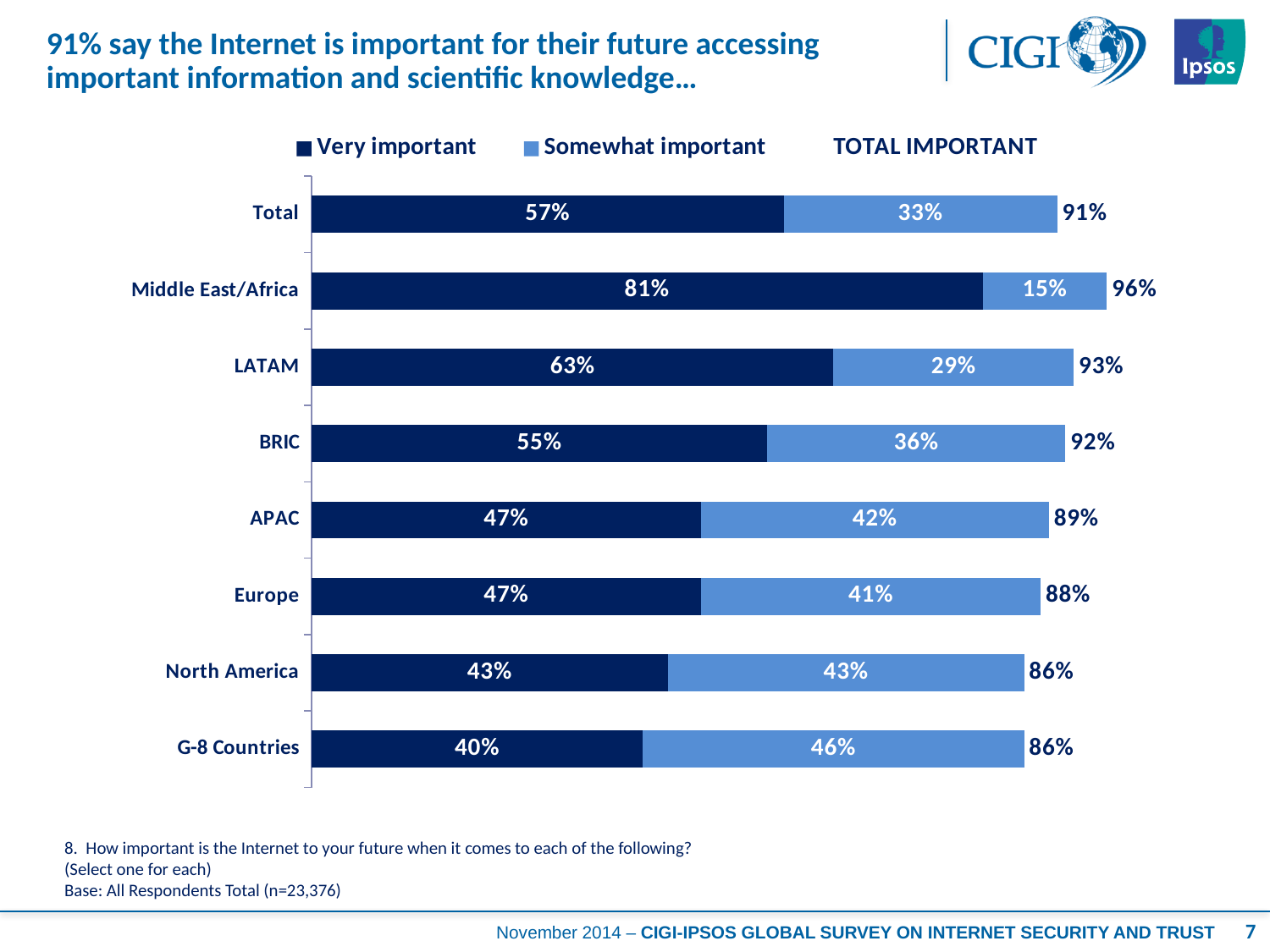
Which category has the lowest 'Very important' value? G-8 Countries Which category has the highest 'Very important' value? Middle East/Africa What is the 'Somewhat important' value for APAC? 42% Which category has the lowest TOTAL IMPORTANT value? North America and G-8 Countries (86%) What is the difference between the 'Very important' values for Middle East/Africa and G-8 Countries? 41 percentage points What is the TOTAL IMPORTANT value for LATAM? 93% What kind of chart is shown on the slide? Stacked bar chart Which is larger, the 'Somewhat important' value for BRIC or for LATAM? BRIC What is the 'Very important' value for Middle East/Africa? 81% What colour represents the 'Very important' series? Dark navy blue